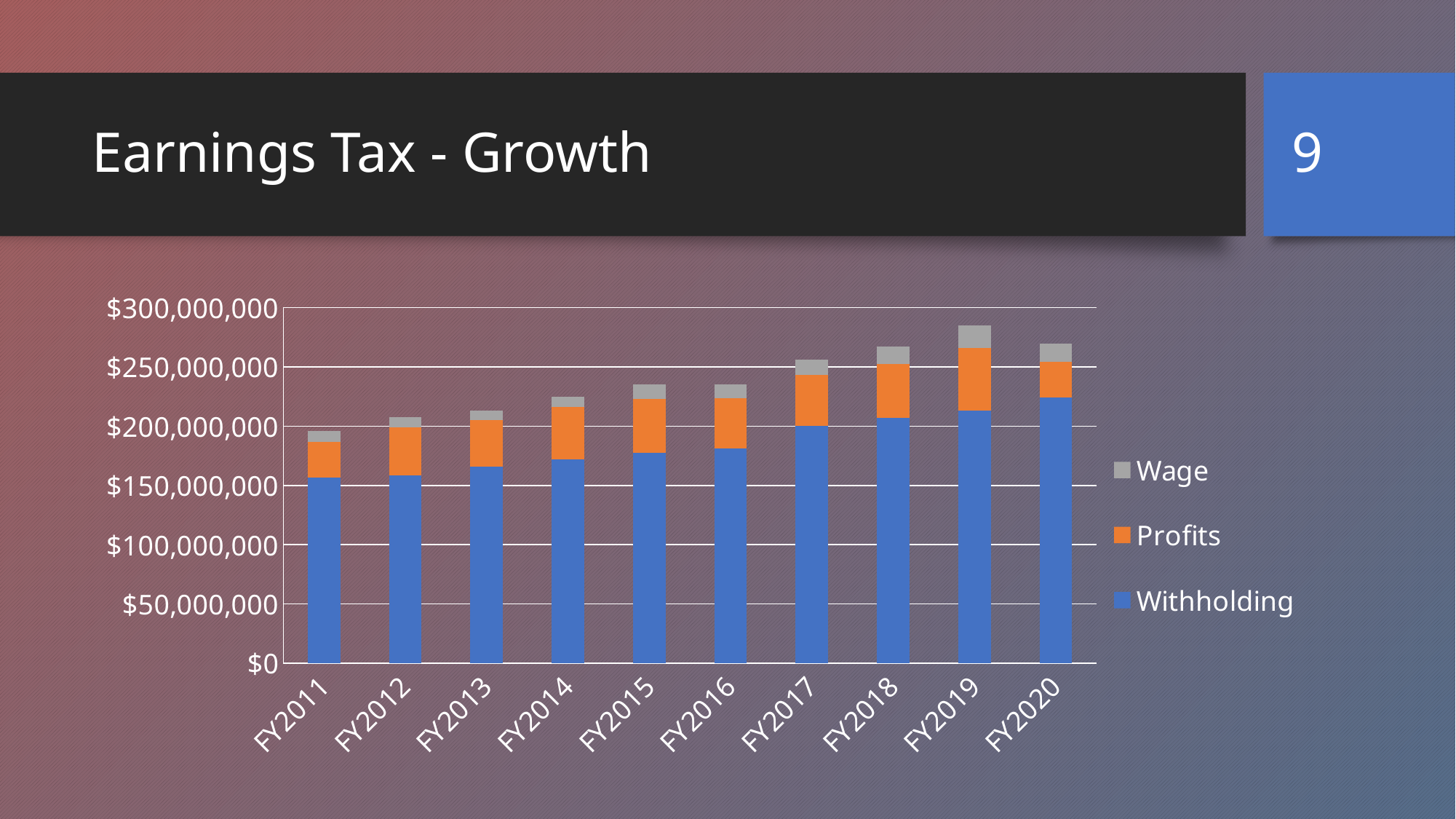
How many series does the chart's legend list? 3 What kind of chart is shown on the slide? Stacked bar chart Is the Withholding value for FY2016 greater or less than $200,000,000? less Does the Withholding series generally rise or fall from FY2011 to FY2020? rise How many fiscal years are shown on the x axis of the chart? 10 Which fiscal year has the largest Withholding value? FY2020 Is the Withholding value for FY2020 greater or less than $200,000,000? greater Which has the larger total stacked bar, FY2019 or FY2020? FY2019 Which fiscal year has the shortest stacked bar (lowest total) in the chart? FY2011 What is the title of the slide containing the chart? Earnings Tax - Growth Is the total stacked bar for FY2019 greater or less than $250,000,000? greater Which fiscal year has the tallest stacked bar (highest total) in the chart? FY2019